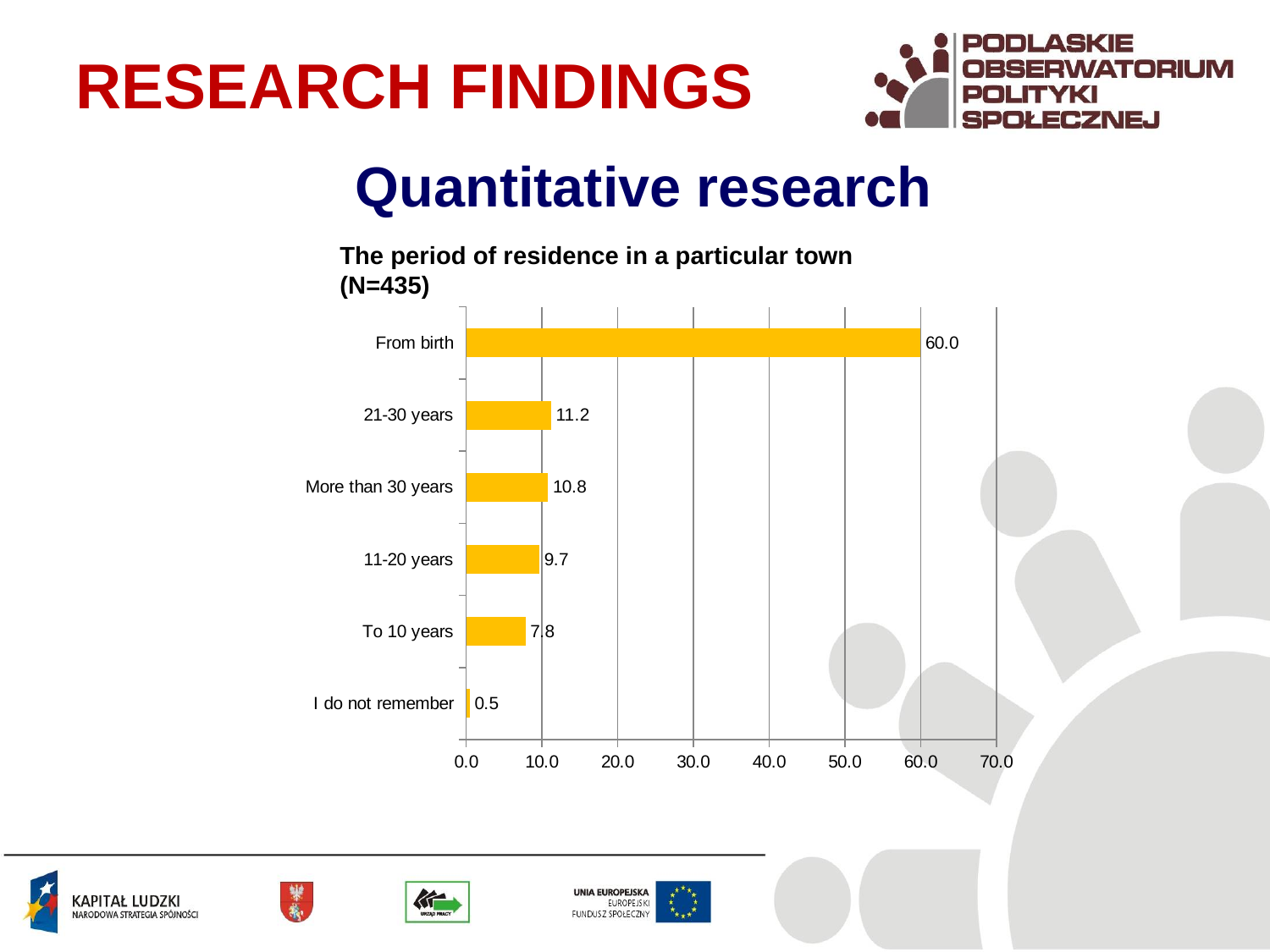
Which category has the lowest value? I do not remember Which category has the highest value? From birth What kind of chart is shown on the slide? Bar chart What is the value for "I do not remember"? 0.5 What is the value for "From birth"? 60.0 What is the value for "To 10 years"? 7.8 Is the value for "From birth" greater or less than 50.0? greater What is the difference between the values for "From birth" and "21-30 years"? 48.8 How many categories are shown in the chart? 6 What is the value for "More than 30 years"? 10.8 What is the value for "21-30 years"? 11.2 Which is larger, the value for "11-20 years" or the value for "To 10 years"? 11-20 years